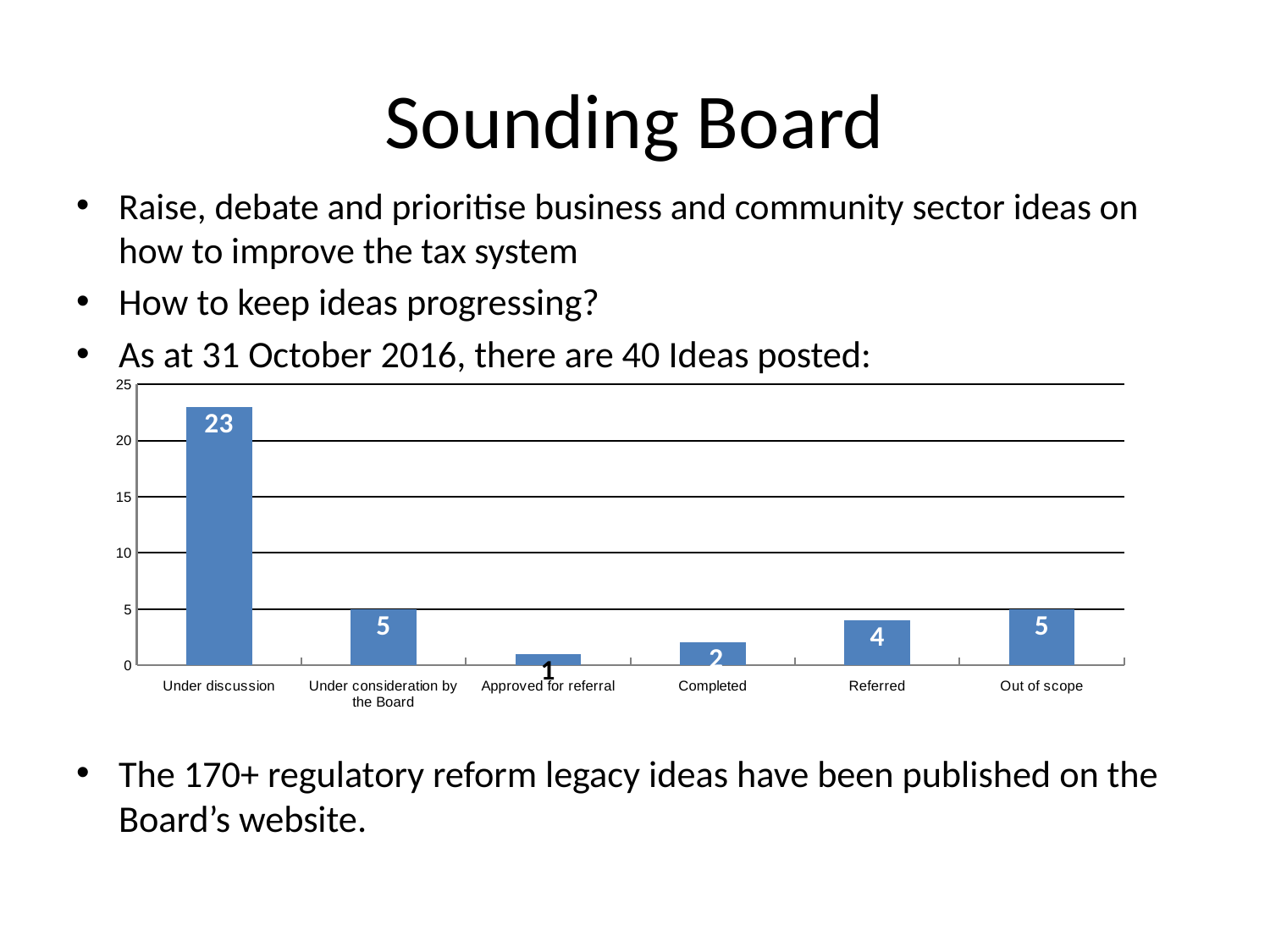
What is the value for Approved for referral? 1 How many categories are shown on the x axis? 6 What is the difference between the values for Under discussion and Referred? 19 Which category has the lowest value? Approved for referral What kind of chart is shown on the slide? bar chart Which is larger, the value for Referred or the value for Completed? Referred Is the value for Under discussion greater or less than 20? greater What is the value for Referred? 4 Which category has the highest value? Under discussion What is the value for Under consideration by the Board? 5 What is the value for Under discussion? 23 What is the value for Completed? 2